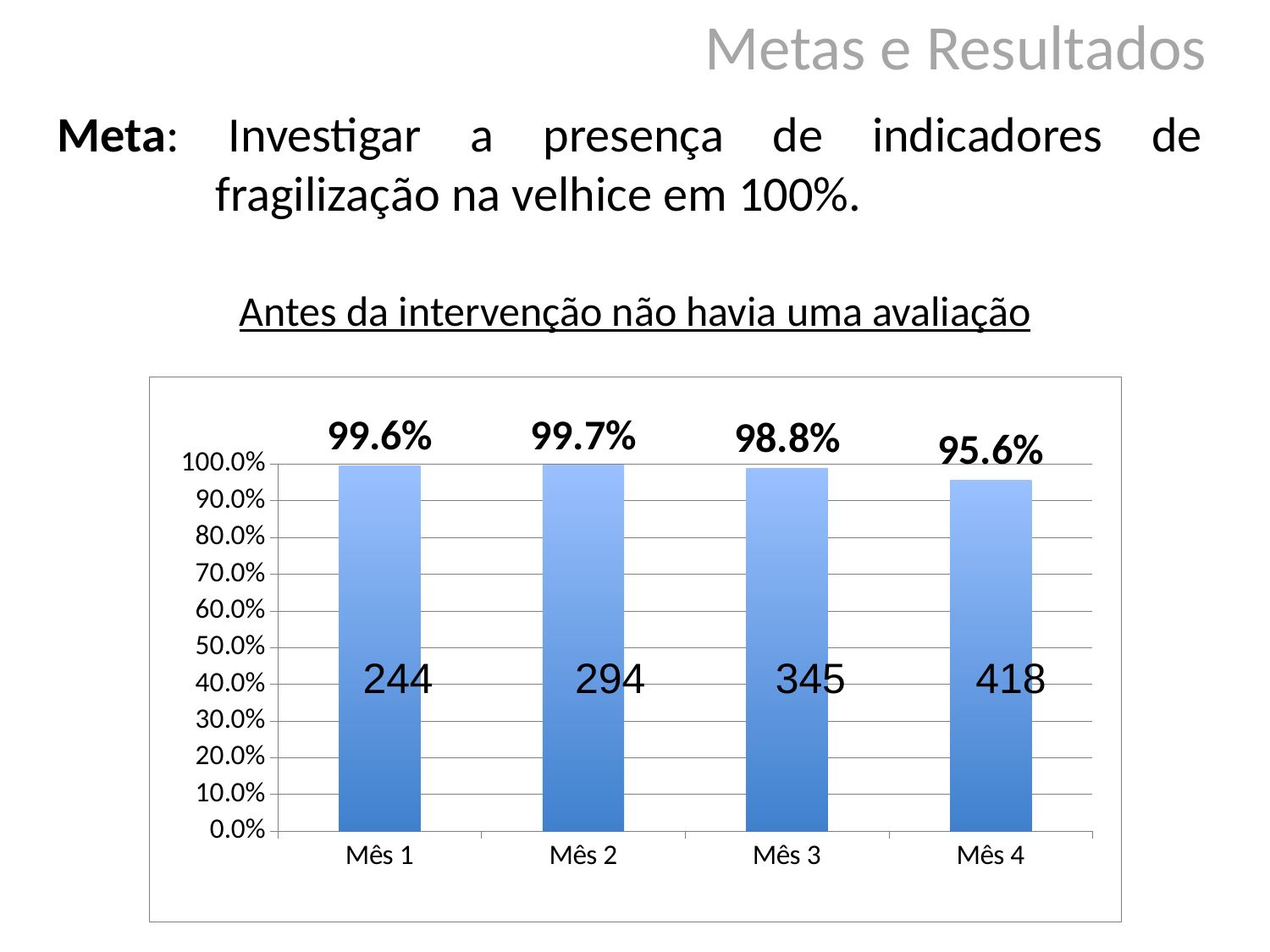
What is the difference between the percentage values for Mês 2 and Mês 4? 4.1% What is the percentage value shown for Mês 4? 95.6% Which is larger, the percentage for Mês 1 or for Mês 3? Mês 1 What kind of chart is shown on the slide? Bar chart What is the maximum value shown on the y axis? 100.0% Which month has the highest percentage value? Mês 2 What number is printed inside the bar for Mês 2? 294 Which month has the lowest percentage value? Mês 4 Do the numbers printed inside the bars rise or fall from Mês 1 to Mês 4? Rise How many months (categories) are shown on the x axis? 4 What number is printed inside the bar for Mês 3? 345 What is the percentage value shown for Mês 1? 99.6%